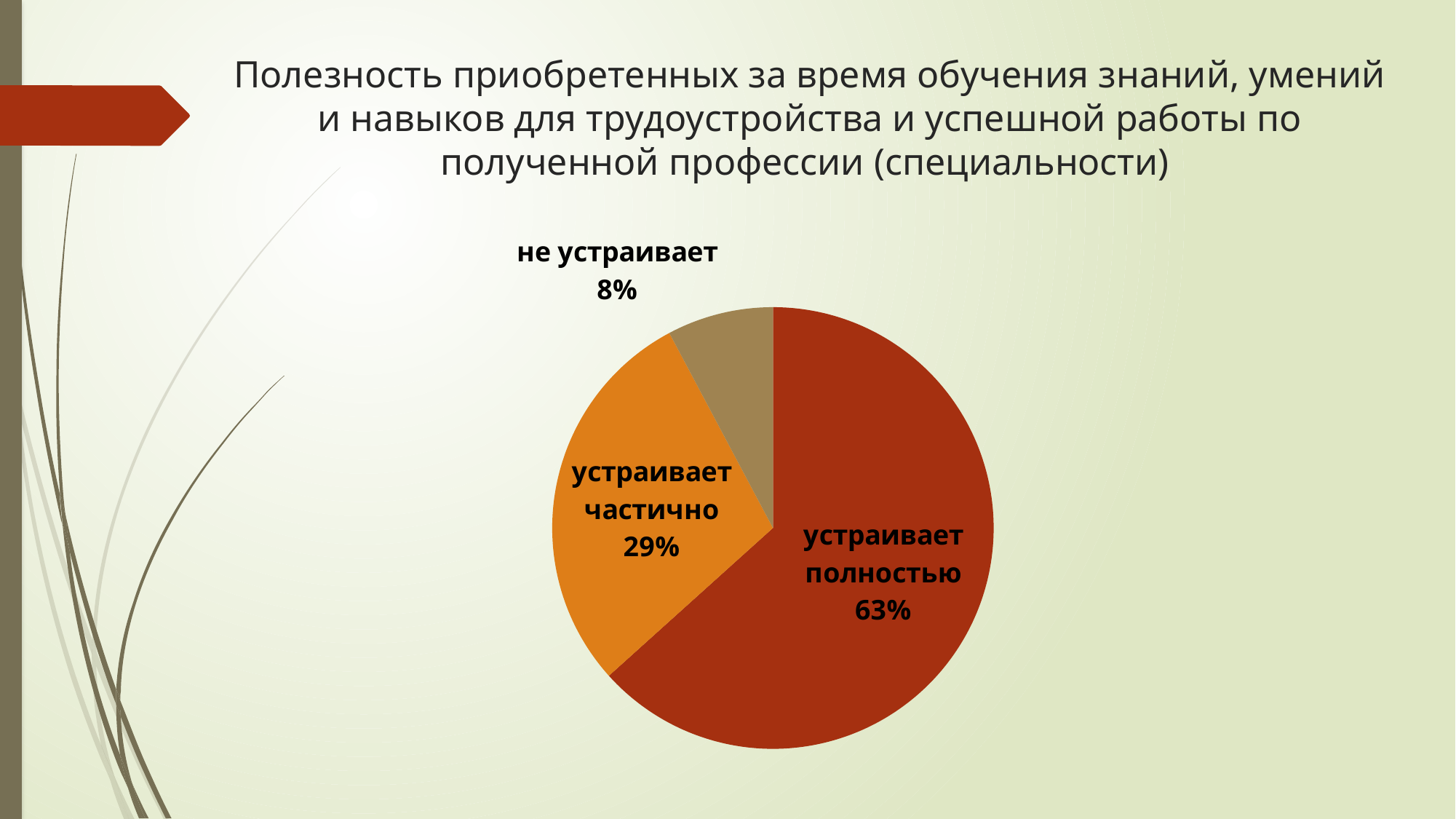
What colour is the slice for "устраивает полностью"? dark red Which is larger: the slice for "устраивает частично" or the slice for "не устраивает"? устраивает частично What share of the pie is labelled "не устраивает"? 8% Which category has the smallest slice of the pie? не устраивает What is the difference in percentage points between "устраивает полностью" and "устраивает частично"? 34 What share of the pie is labelled "устраивает полностью"? 63% What share of the pie is labelled "устраивает частично"? 29% What is the difference in percentage points between "устраивает частично" and "не устраивает"? 21 What type of chart is shown on the slide? pie chart Which category has the largest slice of the pie? устраивает полностью How many slices does the pie chart have? 3 What colour is the slice for "устраивает частично"? orange